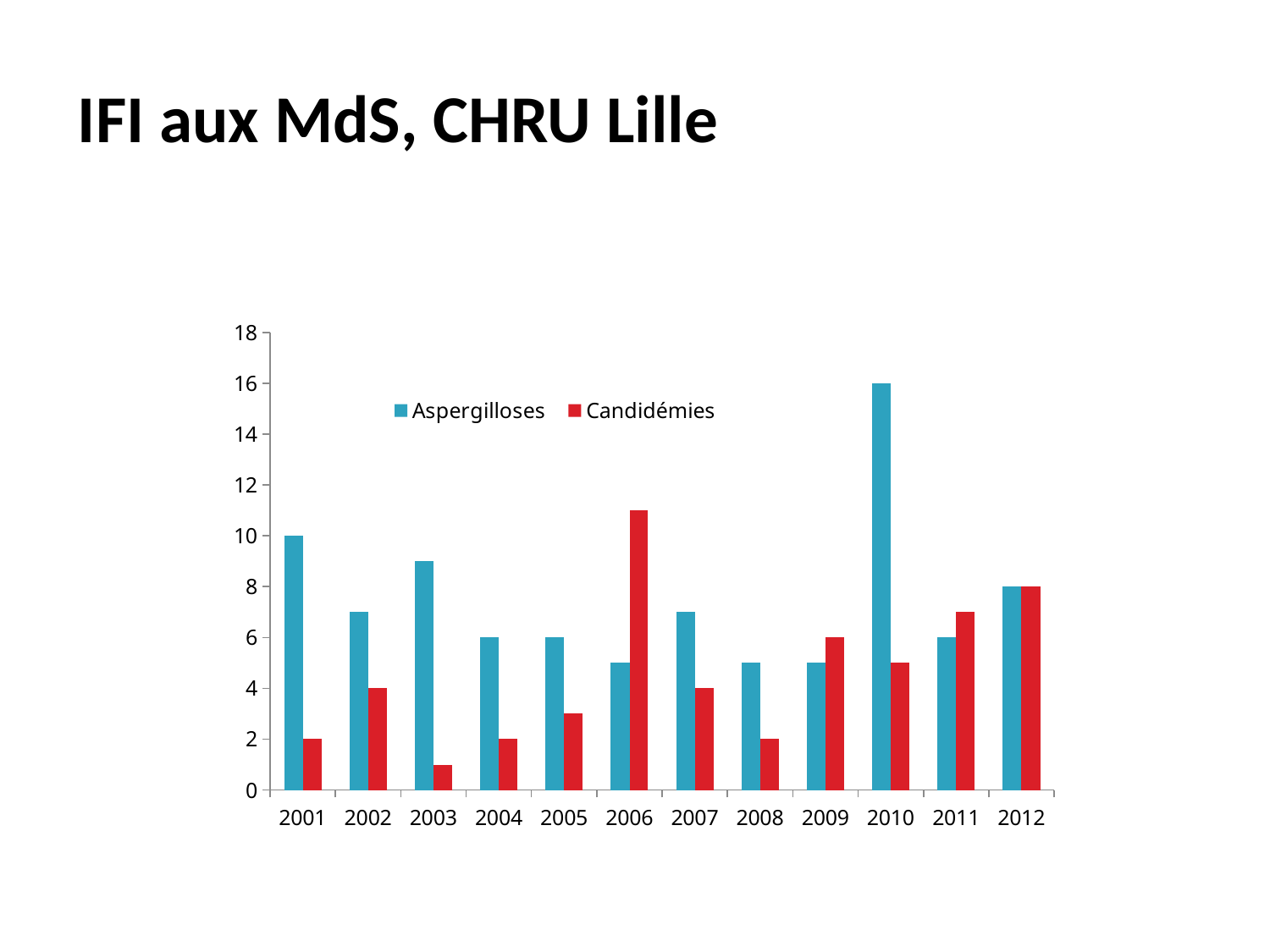
In which year is the Aspergilloses value highest? 2010 Is the value for Candidémies in 2006 greater or less than 10? greater In which year is the Candidémies value lowest? 2003 What is the value for Aspergilloses in 2010? 16 How many series does the legend list? 2 What is the value for Candidémies in 2009? 6 Which is larger in 2009, Aspergilloses or Candidémies? Candidémies What is the value for Aspergilloses in 2001? 10 In which year is the Candidémies value highest? 2006 What is the value for Candidémies in 2012? 8 What type of chart is shown on the slide? bar chart How many years are shown on the x axis? 12